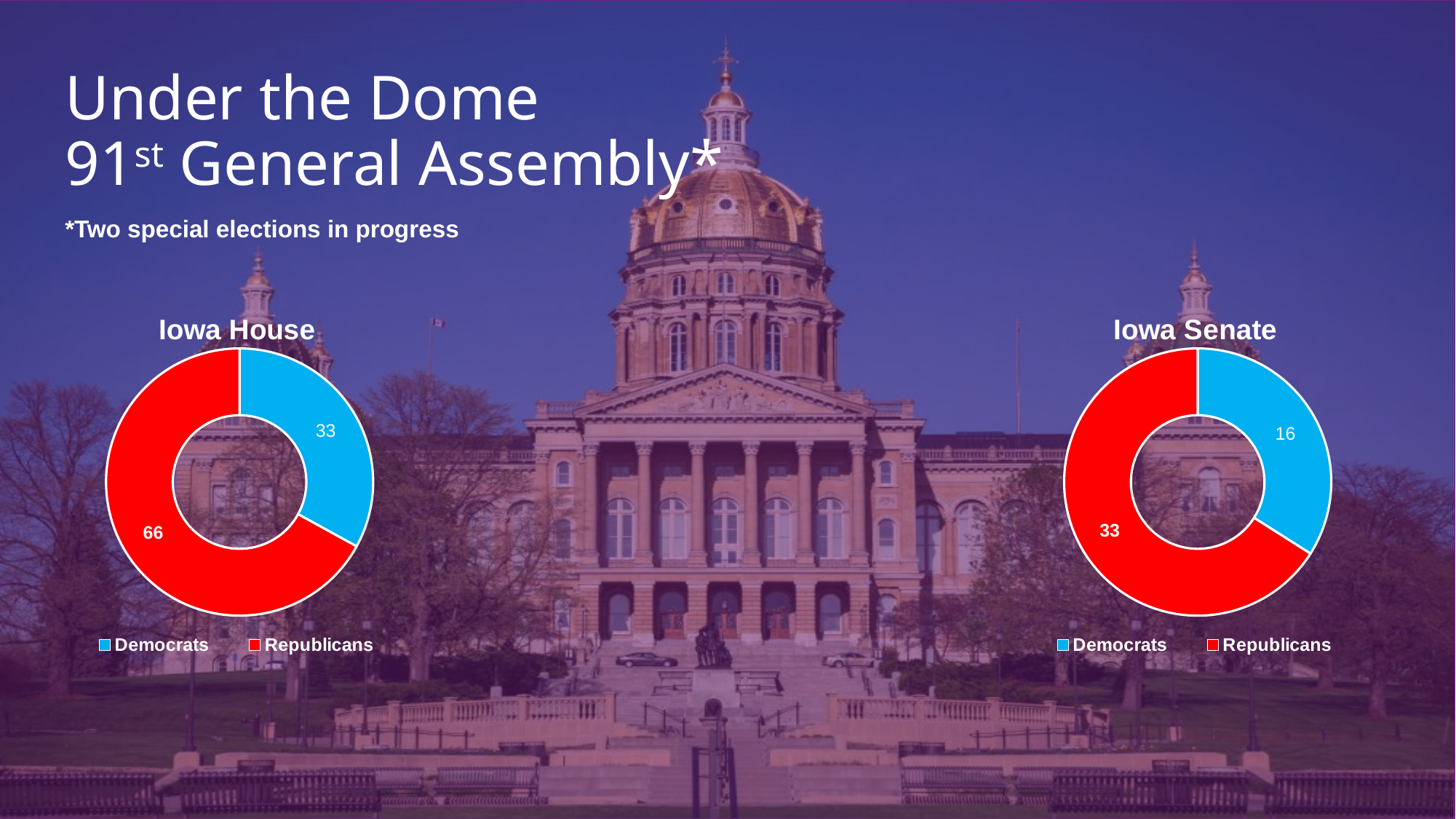
In the Iowa House chart, which party has the larger slice? Republicans In the Iowa Senate chart, what is the difference between the Republican and Democrat values? 17 In the Iowa House chart, what is the difference between the Republican and Democrat values? 33 In the Iowa Senate chart, what is the total of the two slices? 49 In the Iowa House chart, what is the total of the two slices? 99 In the Iowa House chart, how many seats do Republicans hold? 66 In the Iowa House chart, how many seats do Democrats hold? 33 How many entries does the legend of the Iowa House chart list? 2 In the Iowa Senate chart, what is the value for Republicans? 33 In the Iowa Senate chart, what is the value for Democrats? 16 What kind of chart is the Iowa Senate chart? Doughnut (pie) chart In the Iowa Senate chart, which party has the smaller slice? Democrats